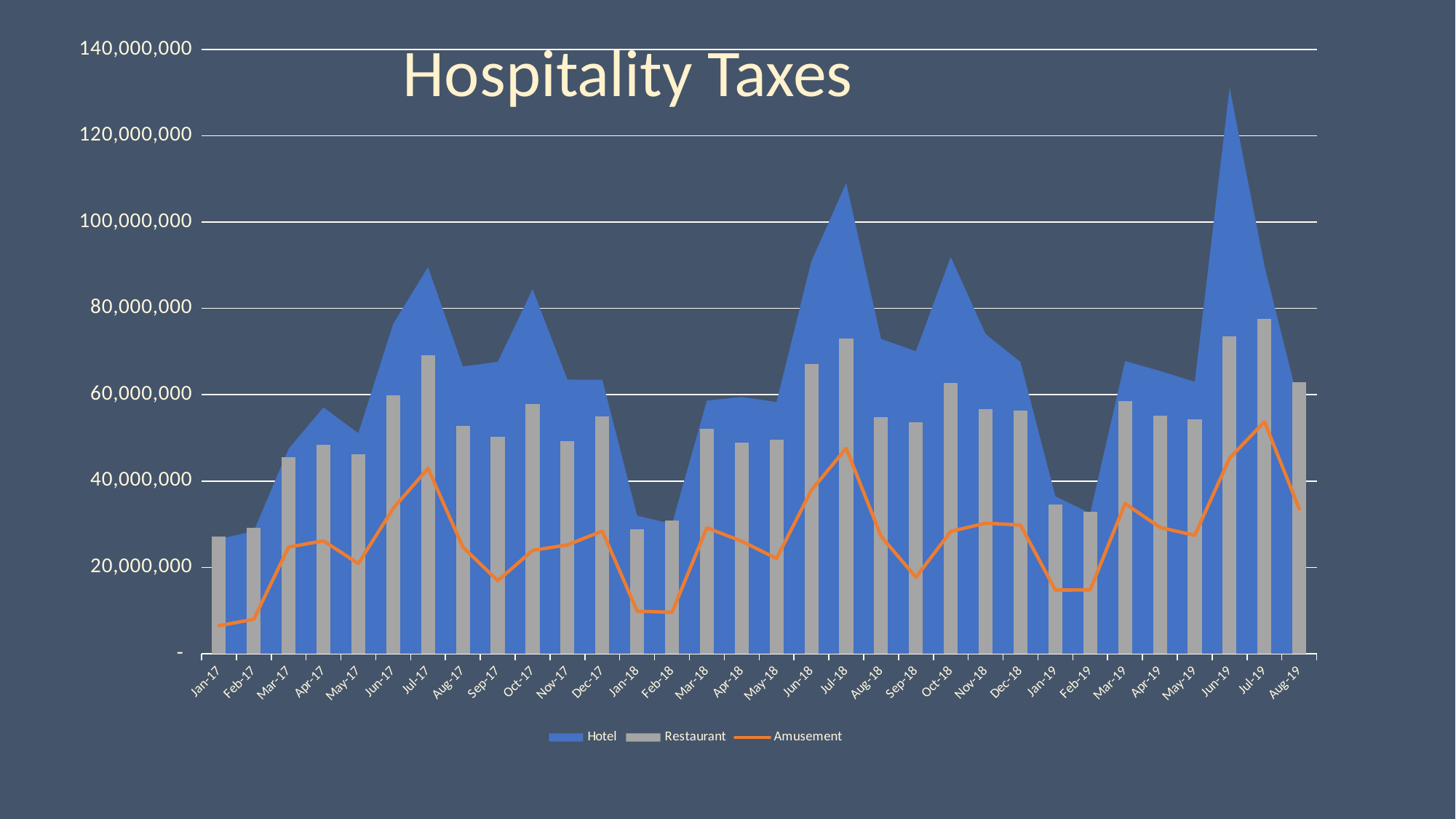
In which month does the Hotel series reach its highest value? Jun-19 Is the Restaurant value for Jul-19 greater or less than 60,000,000? greater Which is larger, the Hotel value for Jul-17 or the Hotel value for Jul-18? Jul-18 In which month is the Amusement series at its lowest? Jan-17 How many months are shown along the x axis? 32 Is the Hotel value for Jun-19 greater or less than 120,000,000? greater Is the Amusement value for Feb-18 greater or less than 20,000,000? less Which series is plotted as an orange line? Amusement How many series does the legend list? 3 What is the title of the chart? Hospitality Taxes In which month does the Restaurant series reach its highest value? Jul-19 Does the Amusement series rise or fall from Jan-17 to Jul-17? rise